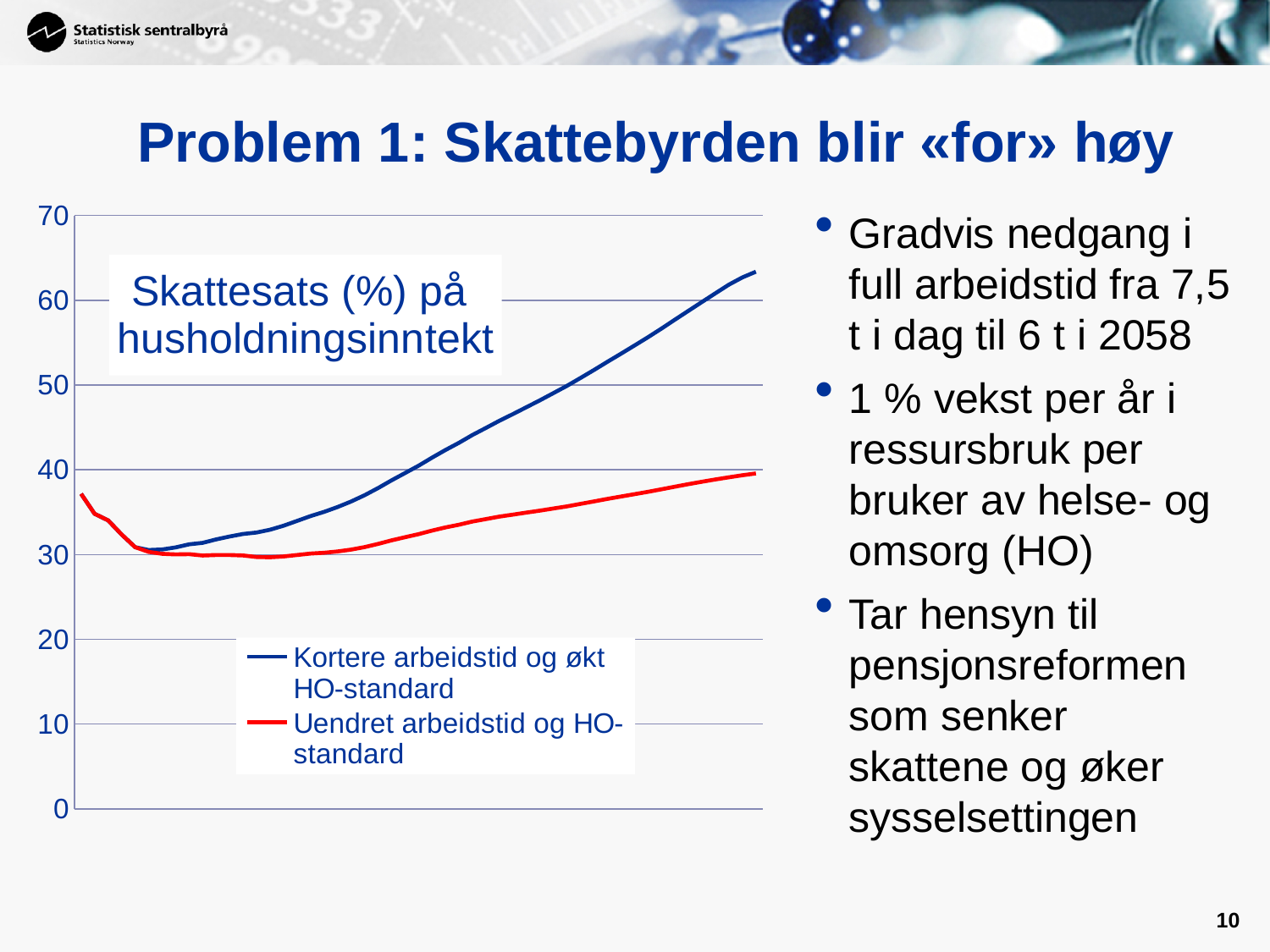
What is the title of the chart? Skattesats (%) på husholdningsinntekt At the right end of the chart, is the value for "Uendret arbeidstid og HO-standard" greater or less than 50? less Which colour is used for the series "Uendret arbeidstid og HO-standard"? red Which series ends higher at the right end of the chart, "Kortere arbeidstid og økt HO-standard" or "Uendret arbeidstid og HO-standard"? Kortere arbeidstid og økt HO-standard Over the right half of the chart, does the "Kortere arbeidstid og økt HO-standard" line rise or fall? rise What kind of chart is shown on the slide? line chart At the right end of the chart, is the value for "Uendret arbeidstid og HO-standard" greater or less than 30? greater Which series reaches the highest value anywhere on the chart? Kortere arbeidstid og økt HO-standard At the right end of the chart, is the value for "Kortere arbeidstid og økt HO-standard" greater or less than 60? greater How many series does the chart's legend list? 2 What is the highest value shown on the chart's vertical axis? 70